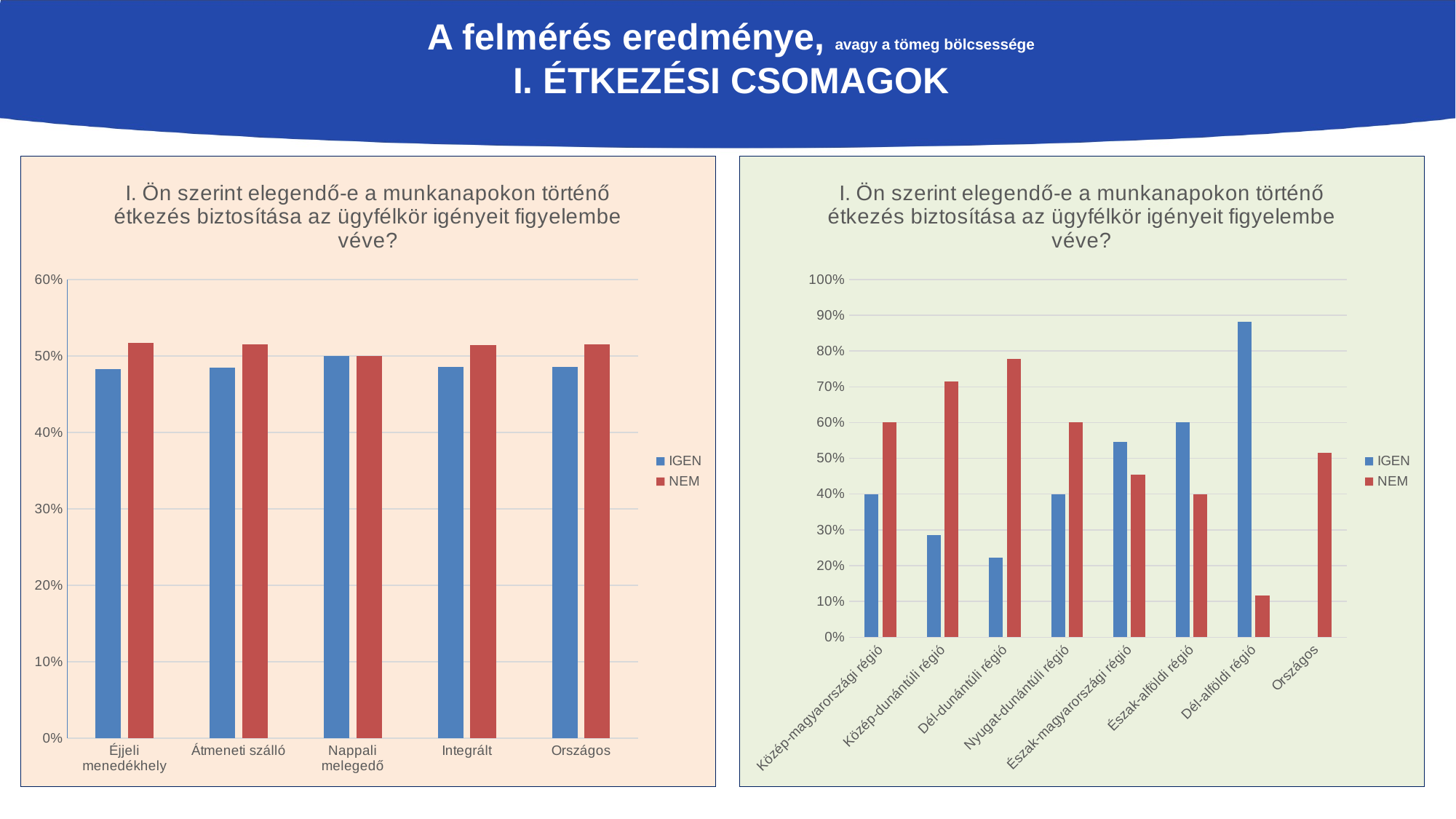
How many series does the legend of the right chart list? 2 What kind of chart is the left chart? bar chart In the right chart, which category has the lowest IGEN value? Dél-dunántúli régió In the right chart, which is larger for Közép-dunántúli régió, IGEN or NEM? NEM How many categories are shown on the x axis of the left chart? 5 In the right chart, is the NEM value for Dél-dunántúli régió greater or less than 70%? greater How many categories are shown on the x axis of the right chart? 8 In the right chart, which category has the lowest NEM value? Dél-alföldi régió In the left chart, is the IGEN value for Éjjeli menedékhely greater or less than 50%? less In the right chart, which category has the highest IGEN value? Dél-alföldi régió In the right chart, is the IGEN value for Dél-alföldi régió greater or less than 80%? greater What colour are the NEM bars in the left chart? red